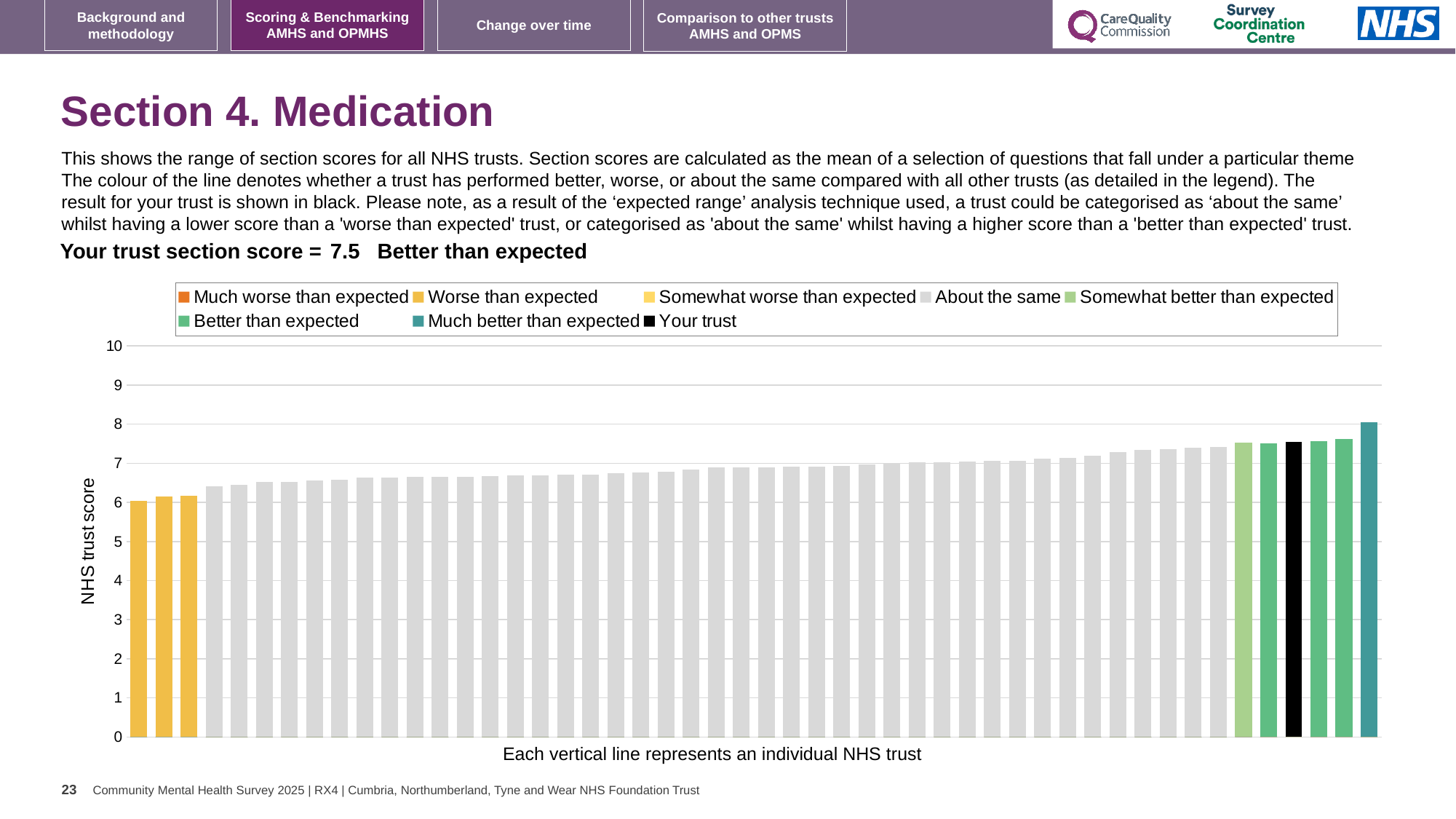
Which legend category do the lowest bars belong to? Worse than expected Is the value of the black 'Your trust' bar greater or less than 7? greater How many bars are coloured as 'Worse than expected'? 3 How many bars are coloured as 'Much better than expected'? 1 Do the bar values rise or fall from left to right across the chart? rise Is the value of the rightmost bar greater or less than 7? greater Is the value of the leftmost bar greater or less than 7? less What kind of chart is shown on the slide? bar chart What is the label on the vertical axis of the chart? NHS trust score Which legend category does the highest bar belong to? Much better than expected How many entries does the chart legend list? 8 What is the section score for your trust (the black bar)? 7.5